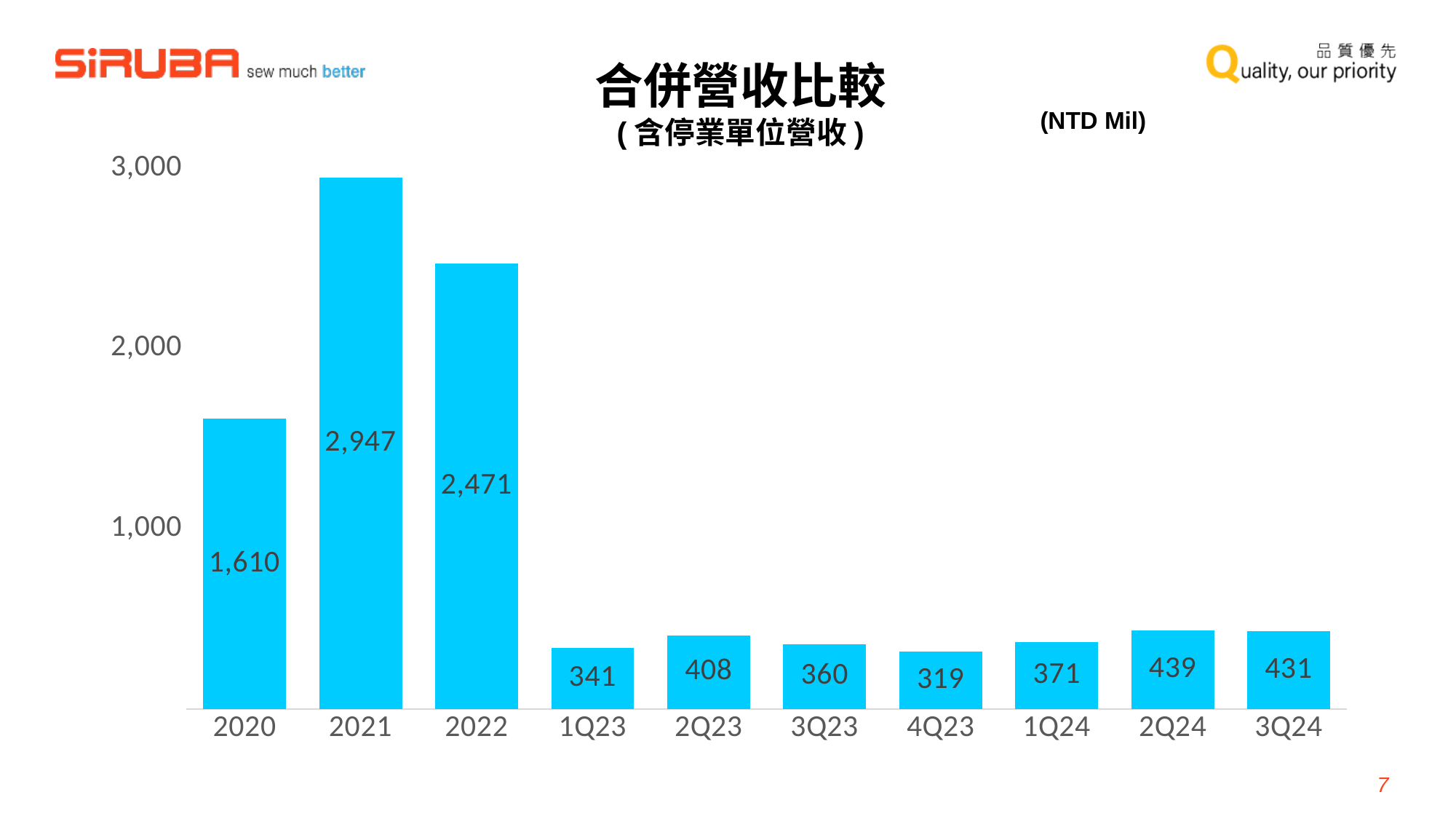
Which category has the highest value? 2021 What is the difference between the values for 2Q24 and 3Q24? 8 Which is larger, the value for 1Q23 or the value for 2Q23? 2Q23 Is the value for 2020 greater or less than 2,000? less What is the value for 2021? 2,947 How many categories are shown on the x axis? 10 What unit is stated for the values on the chart? NTD Mil What kind of chart is shown on the slide? bar chart What is the value for 3Q24? 431 What is the value for 4Q23? 319 What is the difference between the values for 2021 and 2022? 476 Which category has the lowest value? 4Q23